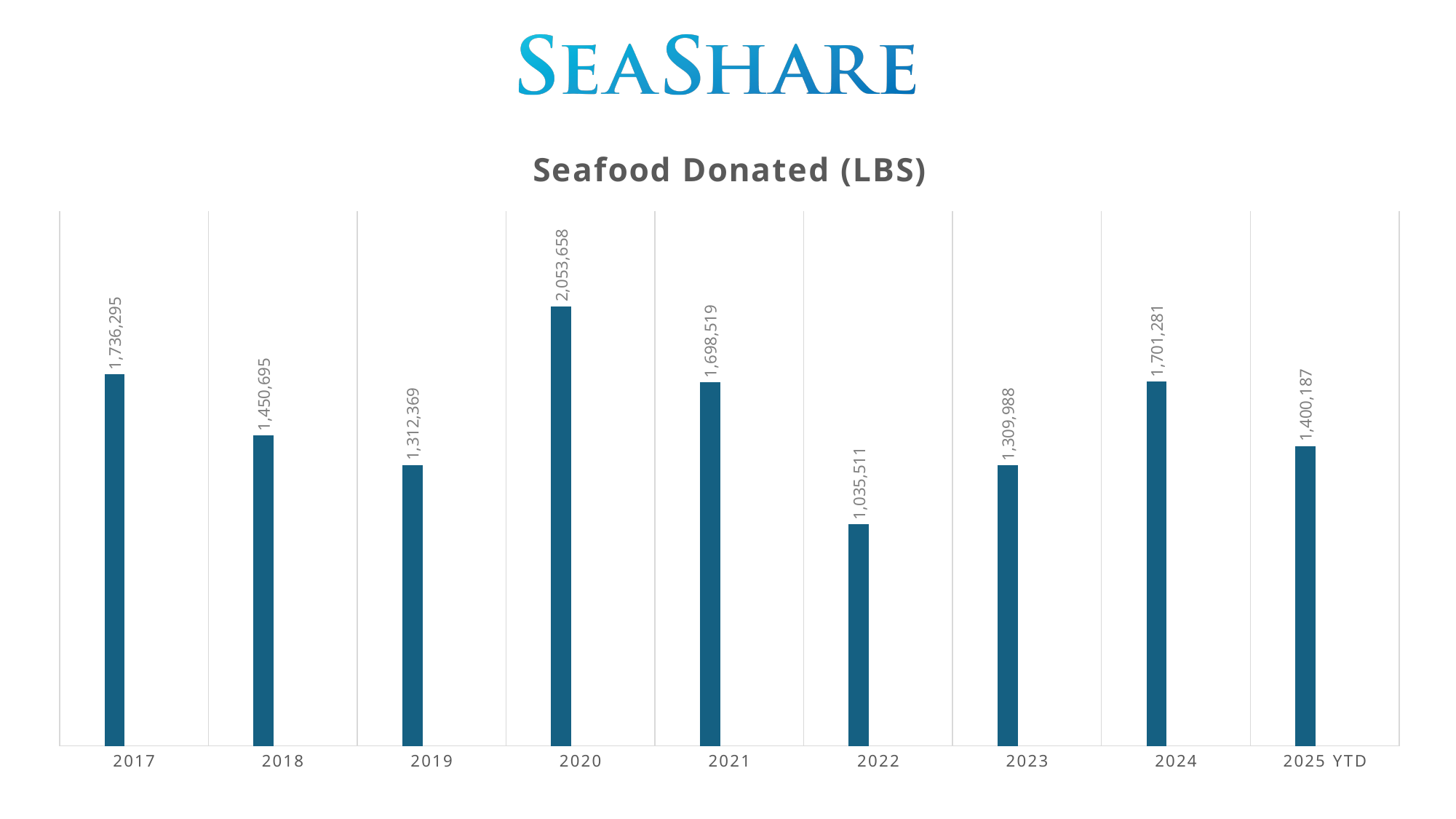
How many pounds of seafood were donated in 2020? 2,053,658 What is the difference between the 2020 value and the 2022 value? 1,018,147 What is the value shown for 2022? 1,035,511 What is the title of the chart? Seafood Donated (LBS) What is the difference between the 2017 value and the 2018 value? 285,600 Which year has the lowest amount of seafood donated? 2022 What is the value shown for 2025 YTD? 1,400,187 Which year has the highest amount of seafood donated? 2020 How many years (categories) are shown on the x axis? 9 What is the value shown for 2017? 1,736,295 Which is larger, the value for 2018 or the value for 2025 YTD? 2018 What kind of chart is shown on the slide? Bar chart